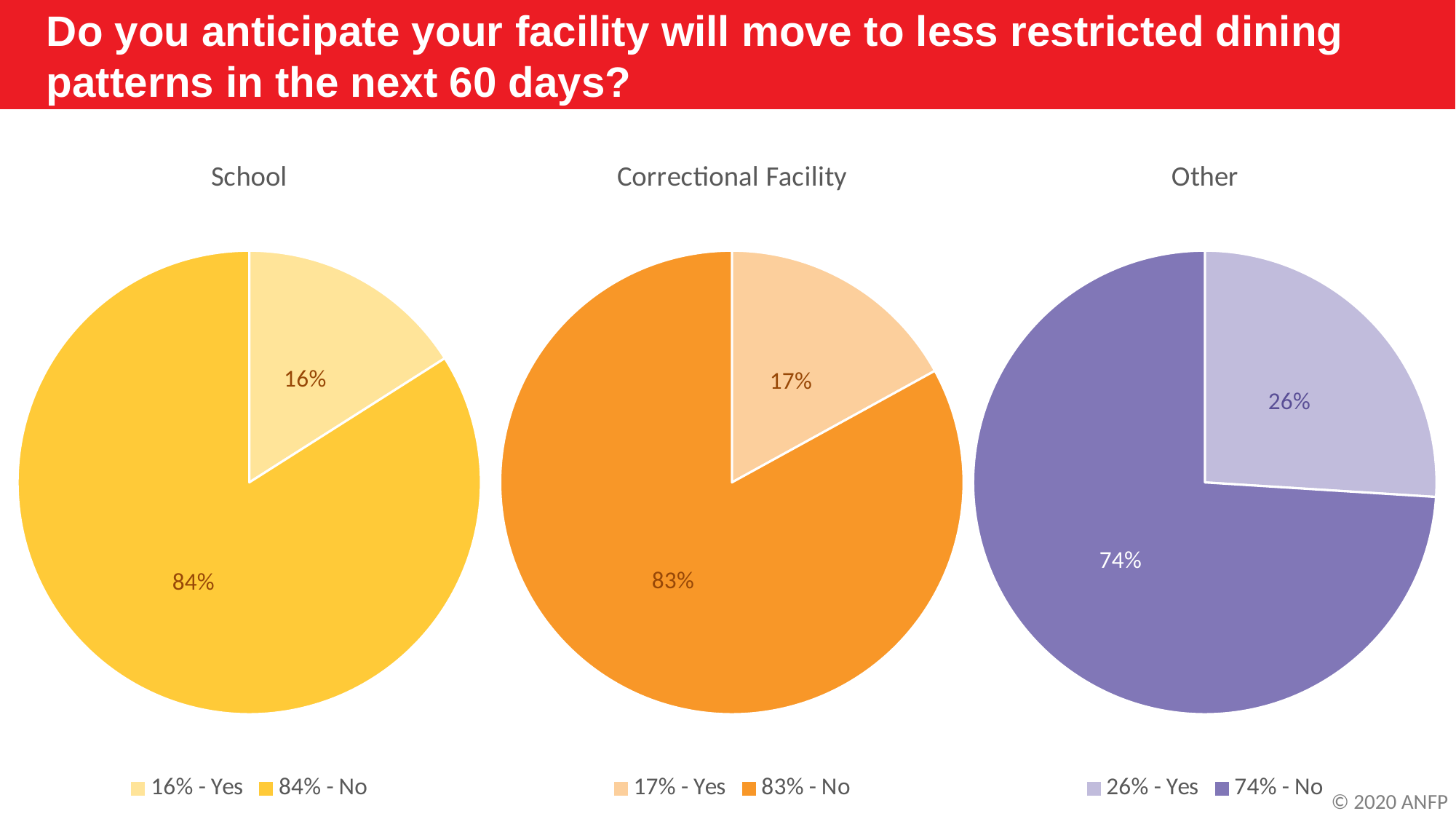
In the Correctional Facility pie chart, what percentage answered No? 83% In the School pie chart, what percentage answered Yes? 16% Which is larger: the Yes share in the Other pie chart or the Yes share in the School pie chart? Other What kind of chart is used for the Other facility type? Pie chart How many pie charts are shown on the slide? 3 In the Other pie chart, what percentage answered Yes? 26% How many slices does the Correctional Facility pie chart have? 2 What share of the Other pie chart does the No slice represent? 74% How many entries does the legend of the School pie chart list? 2 In the Correctional Facility pie chart, what is the difference between the No and Yes shares? 66% In the Other pie chart, which response has the smaller share? Yes In the School pie chart, which response has the larger share? No